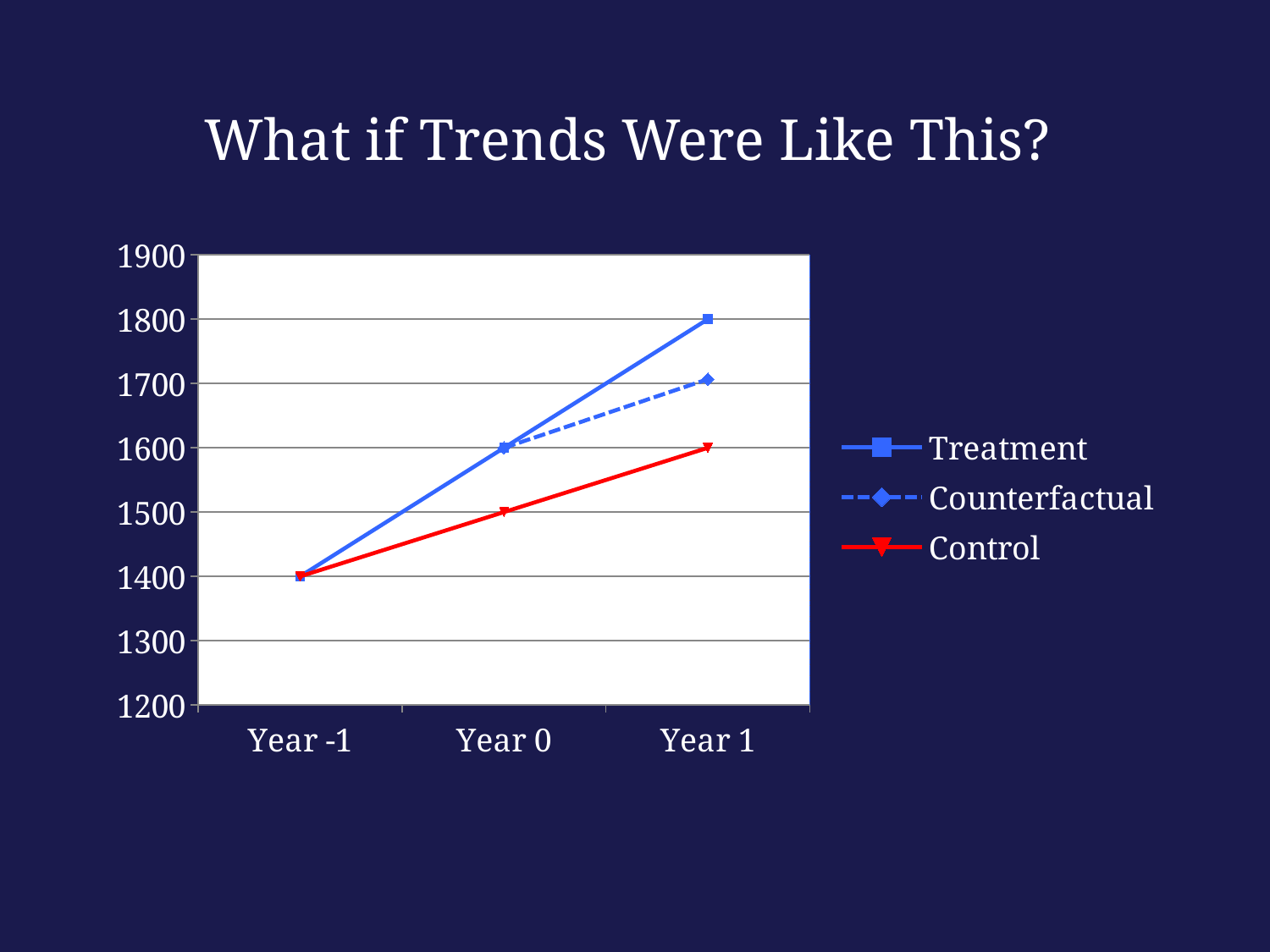
At Year 0, which is larger: Treatment or Control? Treatment Which series has the highest value at Year 1? Treatment How many series does the legend list? 3 What is the difference between Treatment and Control at Year 1? 200 Which series has the lowest value at Year 1? Control What is the value for Treatment at Year -1? 1400 Is the value for Counterfactual at Year 1 greater or less than 1800? less What is the value for Treatment at Year 1? 1800 What is the value for Control at Year 0? 1500 Does the Control series rise or fall from Year -1 to Year 1? rise What kind of chart is shown on the slide? line chart How many points are there along the x axis? 3